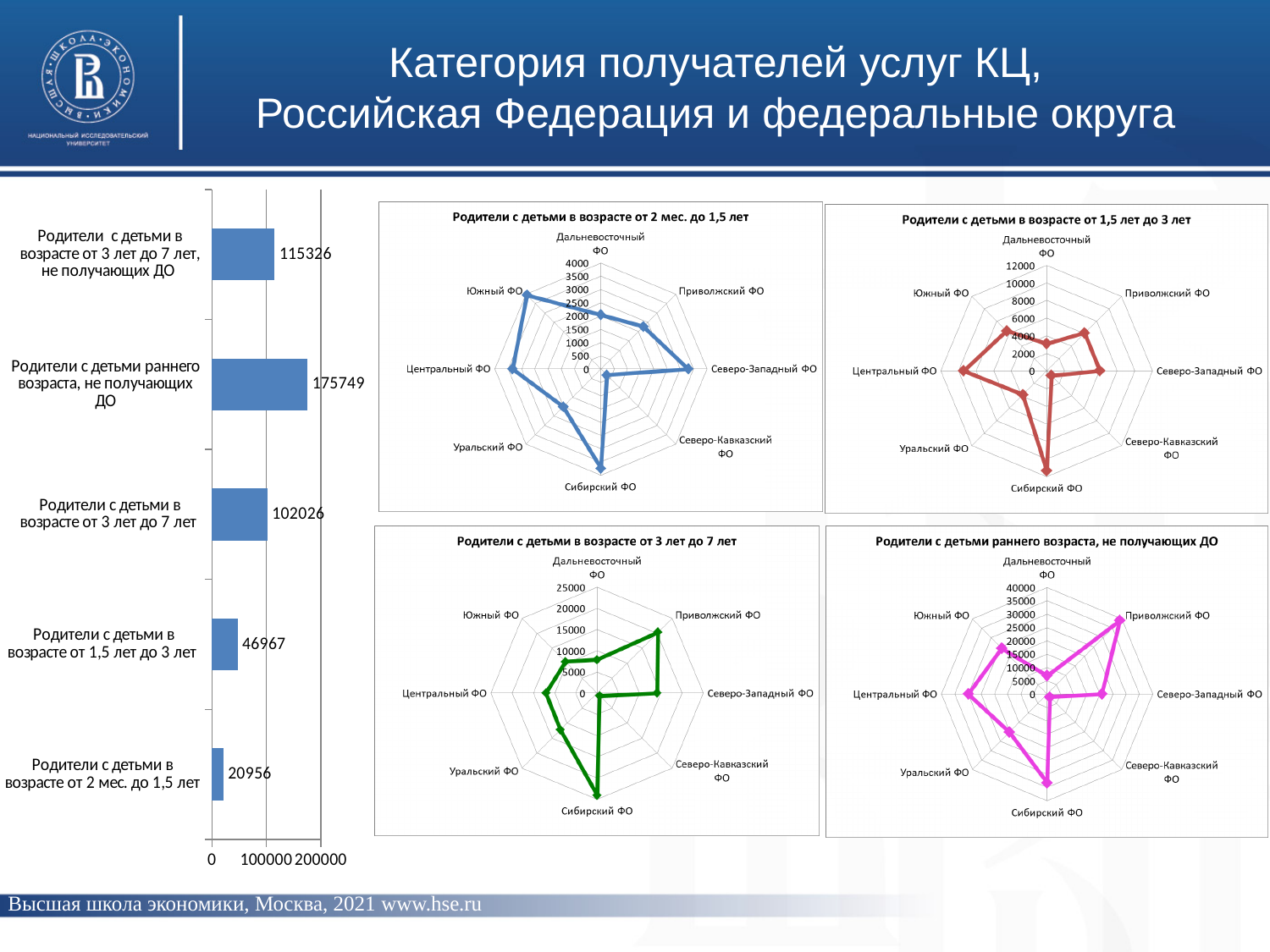
On the bar chart on the left, what is the value for 'Родители с детьми раннего возраста, не получающих ДО'? 175749 How many categories does the bar chart on the left show? 5 On the bar chart on the left, what is the value for 'Родители с детьми в возрасте от 2 мес. до 1,5 лет'? 20956 On the bar chart on the left, which category has the highest value? Родители с детьми раннего возраста, не получающих ДО What type of chart is the chart on the left of the slide? Bar chart On the bar chart on the left, which is larger: the value for 'Родители с детьми в возрасте от 1,5 лет до 3 лет' or for 'Родители с детьми в возрасте от 3 лет до 7 лет'? Родители с детьми в возрасте от 3 лет до 7 лет On the radar chart 'Родители с детьми в возрасте от 3 лет до 7 лет', is the value for Сибирский ФО greater or less than 20000? greater On the bar chart on the left, what is the difference between the values for 'Родители с детьми в возрасте от 3 лет до 7 лет, не получающих ДО' and 'Родители с детьми в возрасте от 3 лет до 7 лет'? 13300 On the radar chart 'Родители с детьми раннего возраста, не получающих ДО', is the value for Приволжский ФО greater or less than 30000? greater On the bar chart on the left, what is the value for 'Родители с детьми в возрасте от 1,5 лет до 3 лет'? 46967 On the bar chart on the left, which category has the lowest value? Родители с детьми в возрасте от 2 мес. до 1,5 лет How many federal districts (axes) does the radar chart 'Родители с детьми в возрасте от 1,5 лет до 3 лет' show? 8